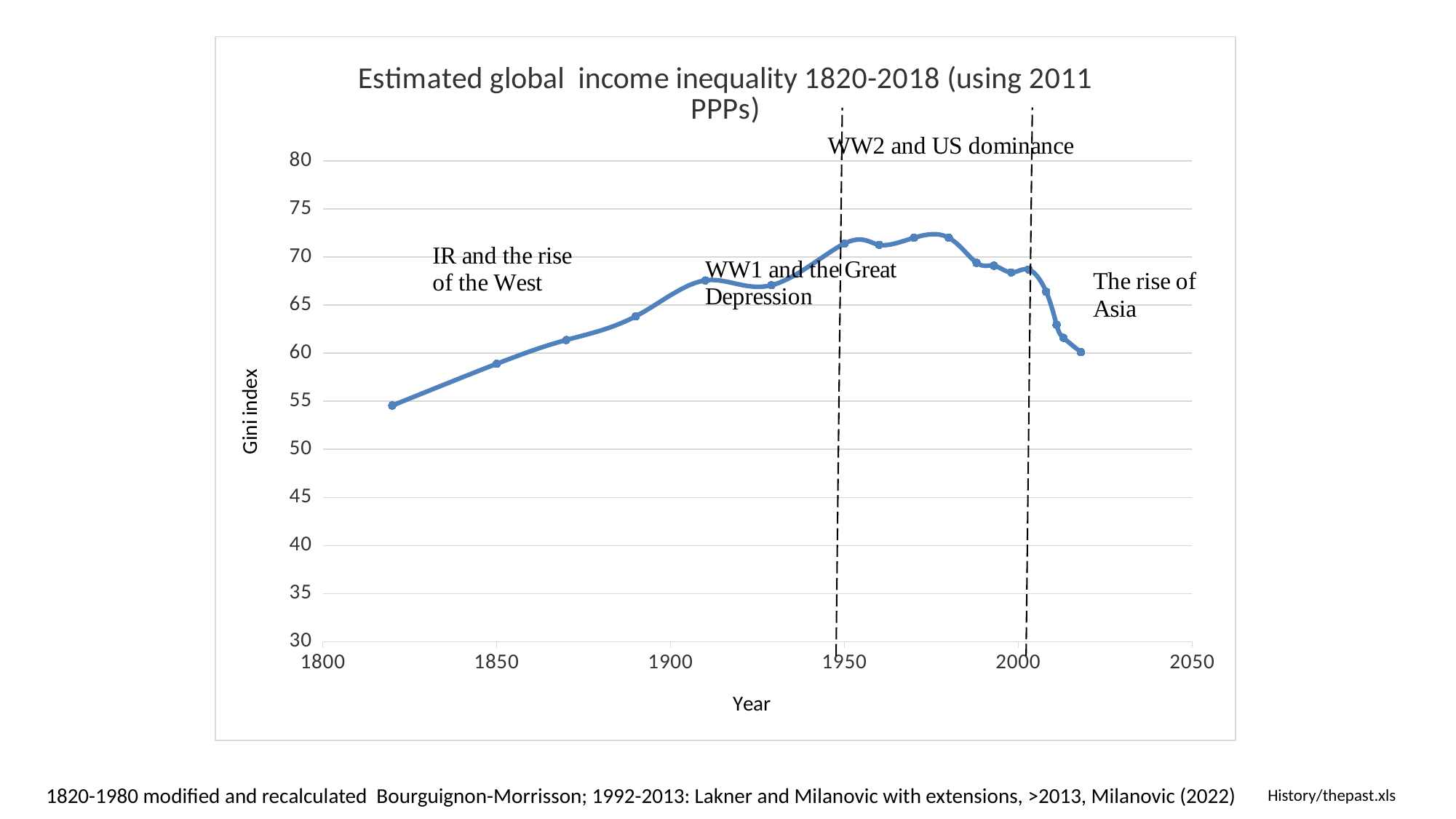
Does the Gini index rise or fall between 1980 and 2018? fall Which year has the lowest Gini index on the chart? 1820 Is the value for 1910 greater or less than 65? greater Is the value for 1970 greater or less than 70? greater Does the Gini index rise or fall between 1820 and 1910? rise Which is larger, the Gini index in 1890 or in 1950? 1950 Is the value for 1820 greater or less than 60? less What is the label of the vertical axis? Gini index What is the title of the chart? Estimated global income inequality 1820-2018 (using 2011 PPPs) What kind of chart is shown on the slide? line chart